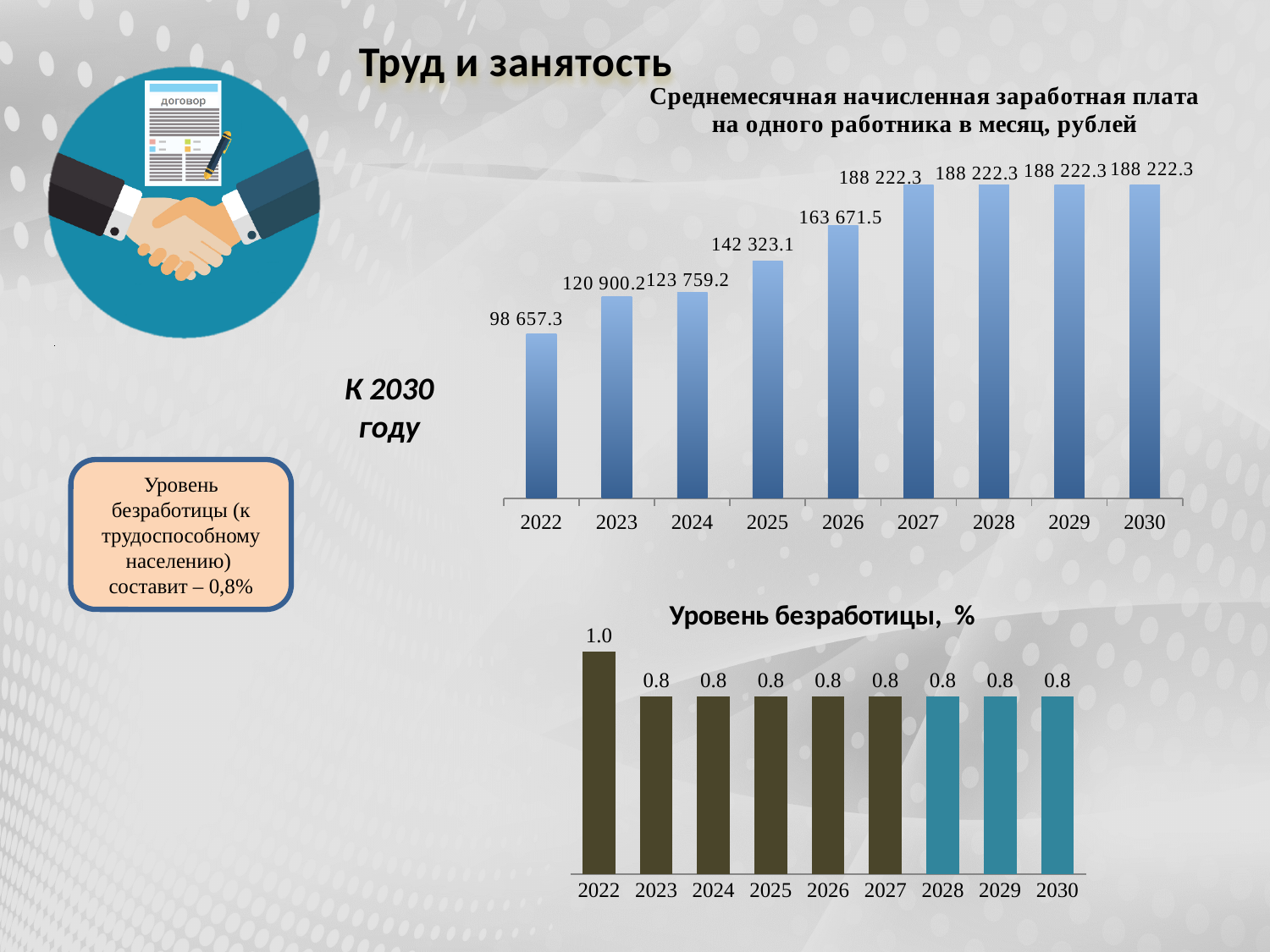
In the bottom chart (Уровень безработицы, %), what is the value for 2022? 1.0 What kind of chart is the bottom chart (Уровень безработицы, %)? bar chart In the top chart (Среднемесячная начисленная заработная плата), do the values rise or fall from 2022 to 2027? rise In the top chart (Среднемесячная начисленная заработная плата), how many years are shown on the x axis? 9 In the bottom chart (Уровень безработицы, %), what is the value for 2030? 0.8 In the top chart (Среднемесячная начисленная заработная плата), which is larger, the value for 2023 or the value for 2024? 2024 In the top chart (Среднемесячная начисленная заработная плата), which year has the lowest value? 2022 In the top chart (Среднемесячная начисленная заработная плата), what is the value for 2026? 163 671.5 In the top chart (Среднемесячная начисленная заработная плата), what is the difference between the values for 2026 and 2025? 21 348.4 In the bottom chart (Уровень безработицы, %), which year has the highest value? 2022 In the top chart (Среднемесячная начисленная заработная плата), what is the value for 2025? 142 323.1 In the top chart (Среднемесячная начисленная заработная плата), what is the value for 2022? 98 657.3